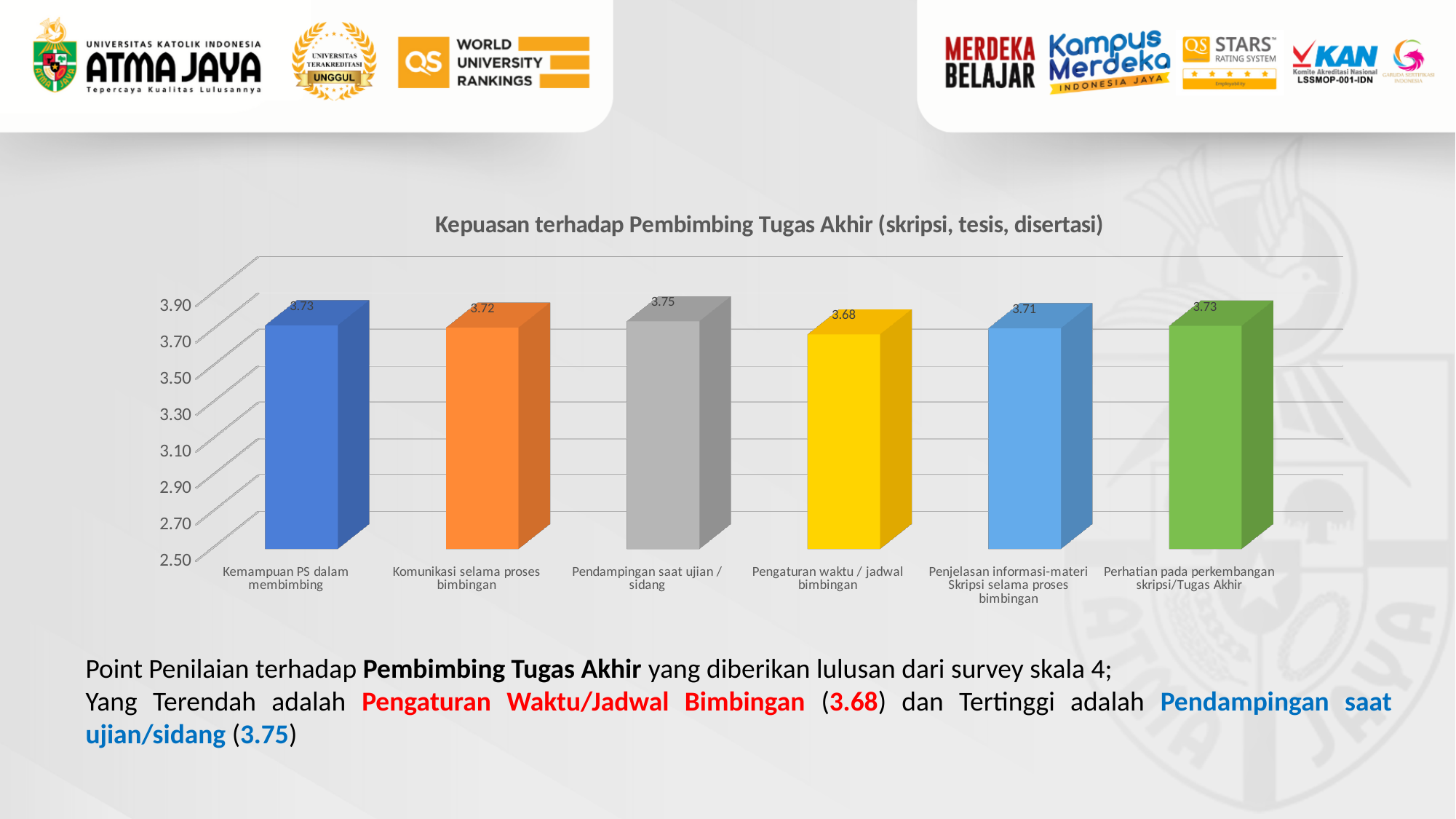
What is the title of the chart? Kepuasan terhadap Pembimbing Tugas Akhir (skripsi, tesis, disertasi) How many categories are plotted in the chart? 6 What is the value for Penjelasan informasi-materi Skripsi selama proses bimbingan? 3.71 What is the value for Pengaturan waktu / jadwal bimbingan? 3.68 Is the value for Perhatian pada perkembangan skripsi/Tugas Akhir greater or less than 3.50? greater Which category has the lowest value? Pengaturan waktu / jadwal bimbingan What kind of chart is shown on the slide? bar chart Which category has the highest value? Pendampingan saat ujian / sidang What is the value for Kemampuan PS dalam membimbing? 3.73 What is the value for Komunikasi selama proses bimbingan? 3.72 Which is larger, the value for Pendampingan saat ujian / sidang or the value for Penjelasan informasi-materi Skripsi selama proses bimbingan? Pendampingan saat ujian / sidang What is the difference between the values for Pendampingan saat ujian / sidang and Pengaturan waktu / jadwal bimbingan? 0.07